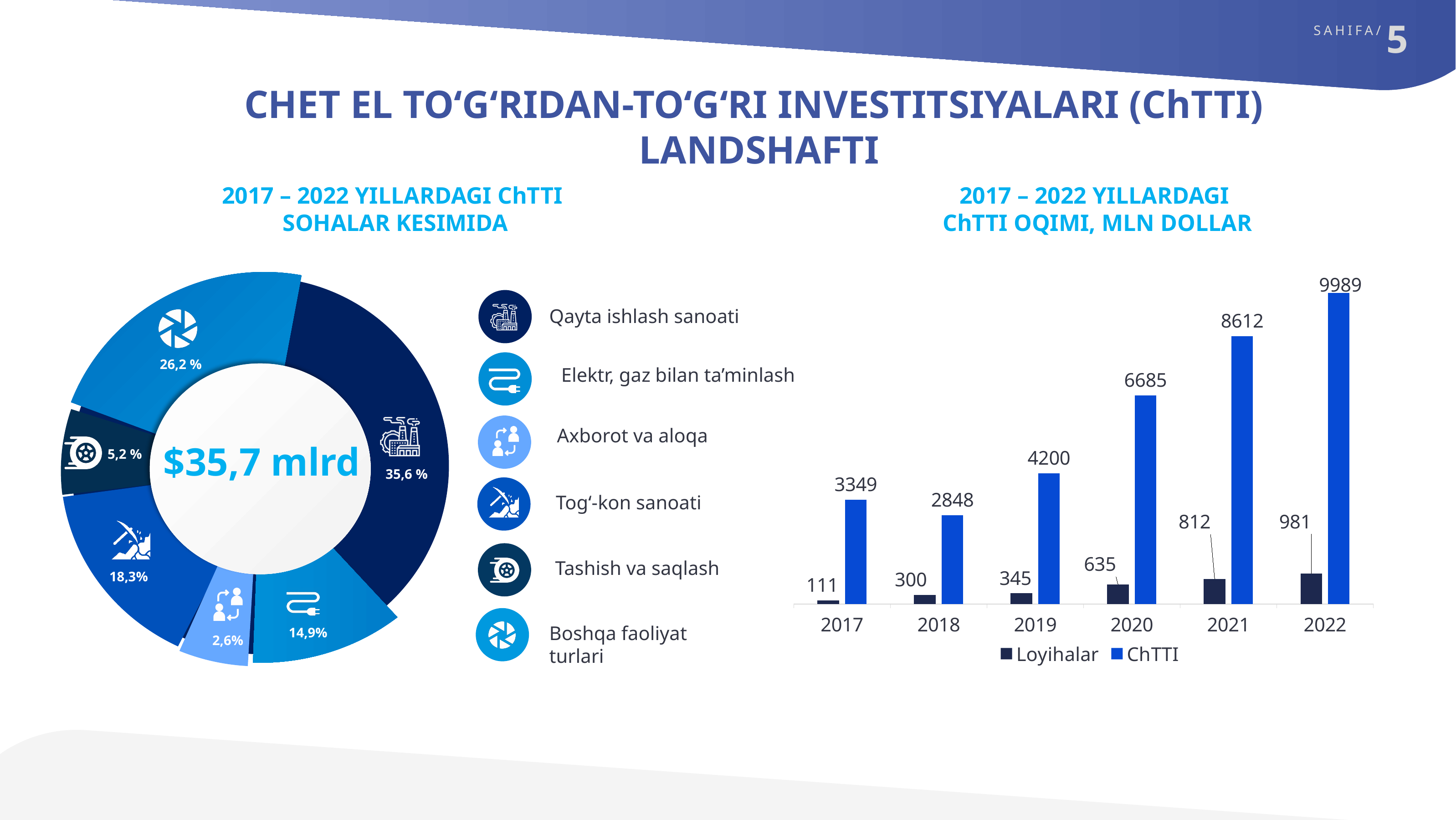
In the bar chart '2017 – 2022 YILLARDAGI ChTTI OQIMI, MLN DOLLAR', which year has the lowest Loyihalar value? 2017 In the pie chart '2017 – 2022 YILLARDAGI ChTTI SOHALAR KESIMIDA', which sector has the smallest share? Axborot va aloqa In the bar chart '2017 – 2022 YILLARDAGI ChTTI OQIMI, MLN DOLLAR', what is the ChTTI value for 2020? 6685 In the bar chart '2017 – 2022 YILLARDAGI ChTTI OQIMI, MLN DOLLAR', which year has the highest ChTTI value? 2022 In the bar chart '2017 – 2022 YILLARDAGI ChTTI OQIMI, MLN DOLLAR', which is larger: the ChTTI value for 2017 or for 2018? 2017 What total value is shown in the centre of the pie chart '2017 – 2022 YILLARDAGI ChTTI SOHALAR KESIMIDA'? $35,7 mlrd In the bar chart '2017 – 2022 YILLARDAGI ChTTI OQIMI, MLN DOLLAR', how many years are shown on the x axis? 6 In the bar chart '2017 – 2022 YILLARDAGI ChTTI OQIMI, MLN DOLLAR', do the Loyihalar values rise or fall from 2017 to 2022? rise In the bar chart '2017 – 2022 YILLARDAGI ChTTI OQIMI, MLN DOLLAR', what is the difference between the ChTTI values for 2022 and 2021? 1377 In the bar chart '2017 – 2022 YILLARDAGI ChTTI OQIMI, MLN DOLLAR', what is the Loyihalar value for 2018? 300 In the bar chart '2017 – 2022 YILLARDAGI ChTTI OQIMI, MLN DOLLAR', how many series does the legend list? 2 In the pie chart '2017 – 2022 YILLARDAGI ChTTI SOHALAR KESIMIDA', what share does Qayta ishlash sanoati have? 35,6 %